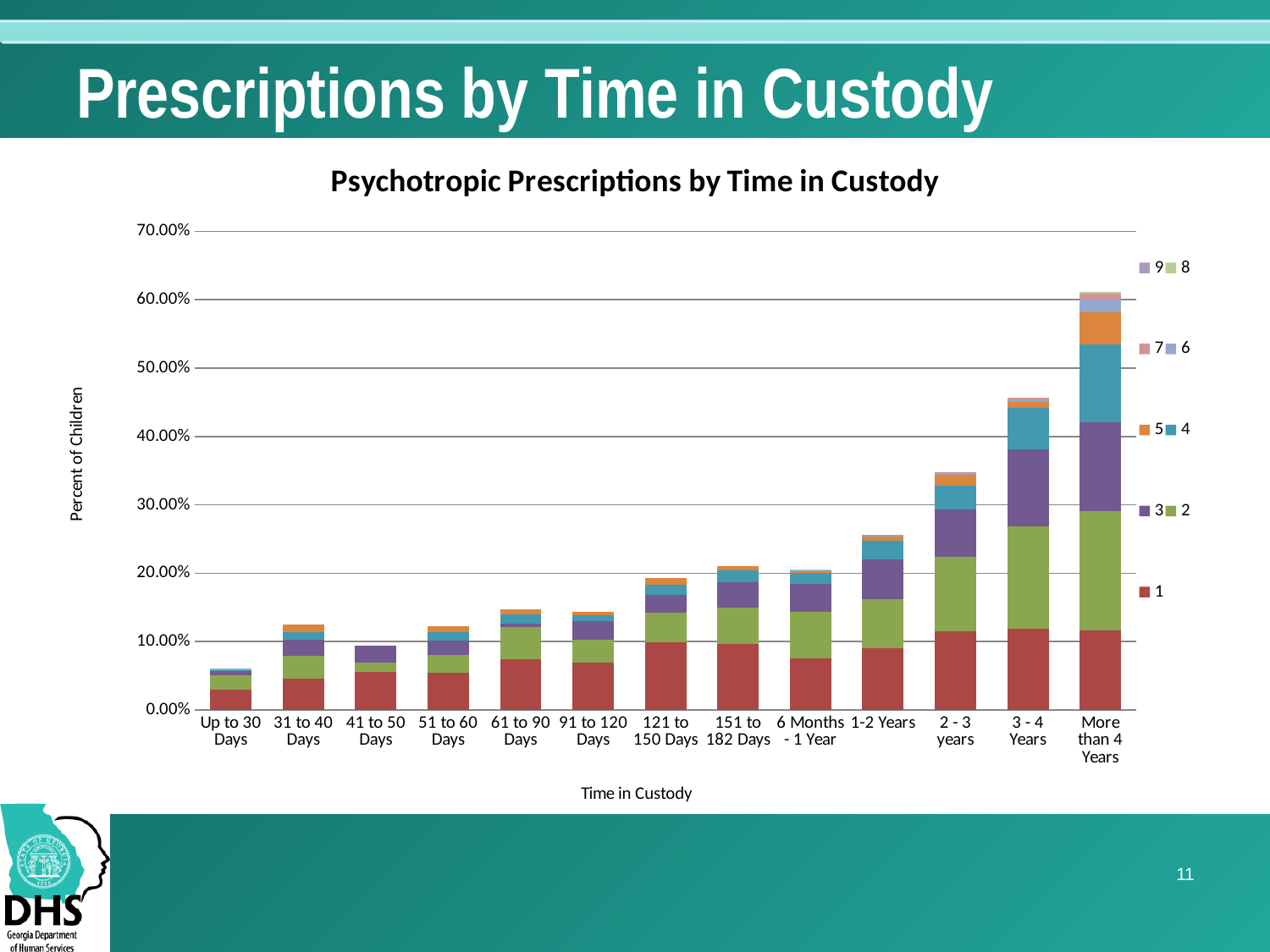
Is the total value for 3 - 4 Years greater or less than 40.00%? greater What kind of chart is shown on the slide? Stacked bar chart Is the total value for 1-2 Years greater or less than 20.00%? greater Which has the larger total bar, 31 to 40 Days or Up to 30 Days? 31 to 40 Days Is the total value for More than 4 Years greater or less than 50.00%? greater How many series does the legend list? 9 What is the title of the chart? Psychotropic Prescriptions by Time in Custody Which time-in-custody category has the tallest stacked bar? More than 4 Years Which time-in-custody category has the shortest stacked bar? Up to 30 Days Do the stacked bar totals generally rise or fall as time in custody increases along the x axis? Rise How many time-in-custody categories are shown on the x axis? 13